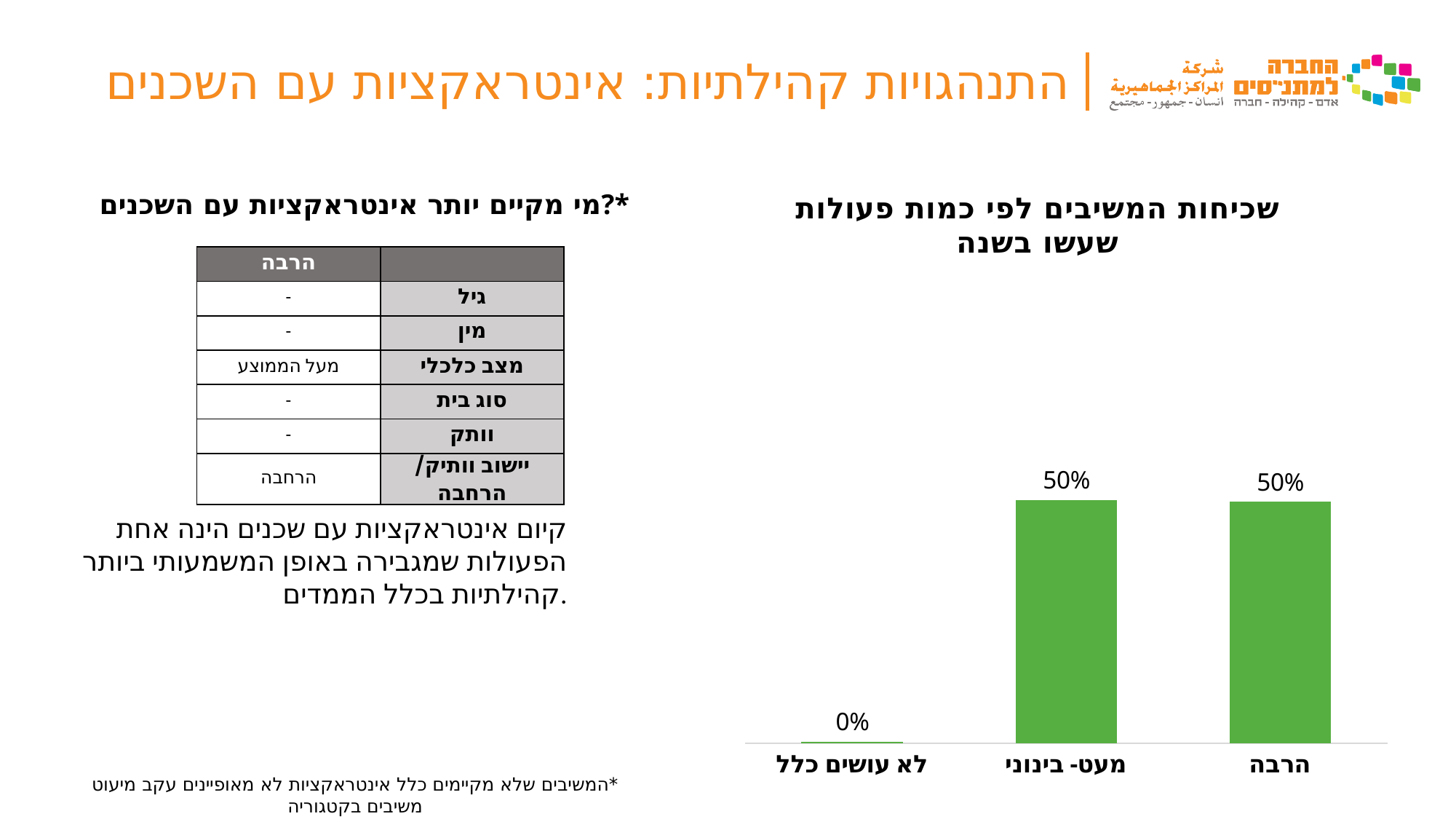
What is the value for "הרבה" in the chart? 50% What is the title of the chart? שכיחות המשיבים לפי כמות פעולות שעשו בשנה What colour are the bars in the chart? green Are the values for "הרבה" and "מעט- בינוני" equal? yes Which is larger, the value for "הרבה" or the value for "לא עושים כלל"? הרבה What is the value for "מעט- בינוני" in the chart? 50% Which category has the lowest value in the chart? לא עושים כלל How many categories are shown in the chart? 3 What is the difference between the value for "מעט- בינוני" and the value for "לא עושים כלל"? 50% What kind of chart is shown on the slide? bar chart What is the value for "לא עושים כלל" in the chart? 0%